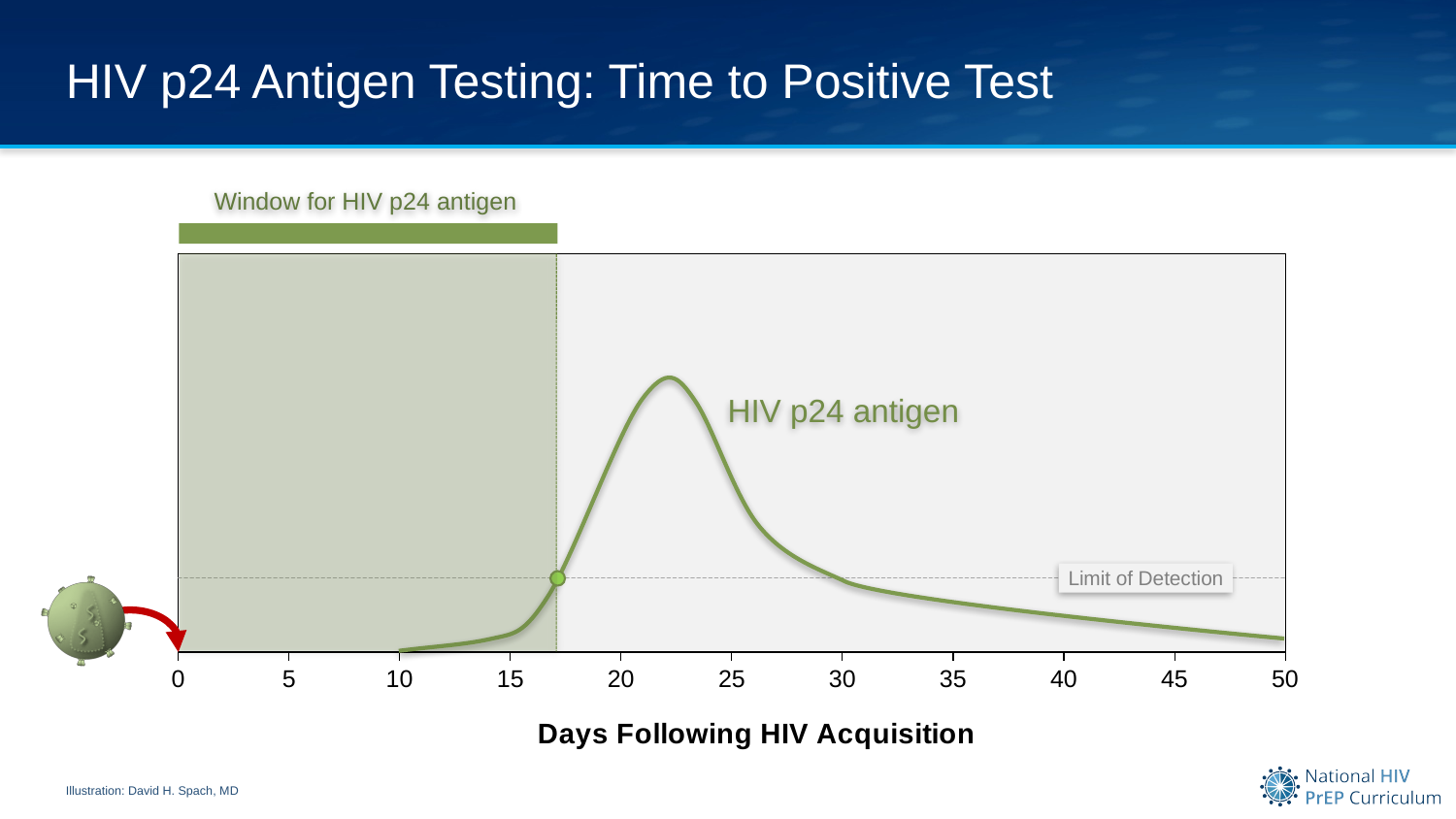
How many tick labels are shown on the x axis? 11 Is the peak of the HIV p24 antigen curve before or after day 25? before Does the HIV p24 antigen curve rise or fall between day 25 and day 50? fall What does the dashed horizontal line on the chart represent? Limit of Detection What is the title of the chart on the slide? HIV p24 Antigen Testing: Time to Positive Test What is the highest value shown on the x axis? 50 Does the HIV p24 antigen curve rise or fall between day 10 and day 20? rise Is the peak of the HIV p24 antigen curve before or after day 20? after What kind of chart is shown on the slide? line chart Does the shaded window for HIV p24 antigen end before or after day 15? after What is the label of the x axis? Days Following HIV Acquisition What is the name of the curve plotted on the chart? HIV p24 antigen